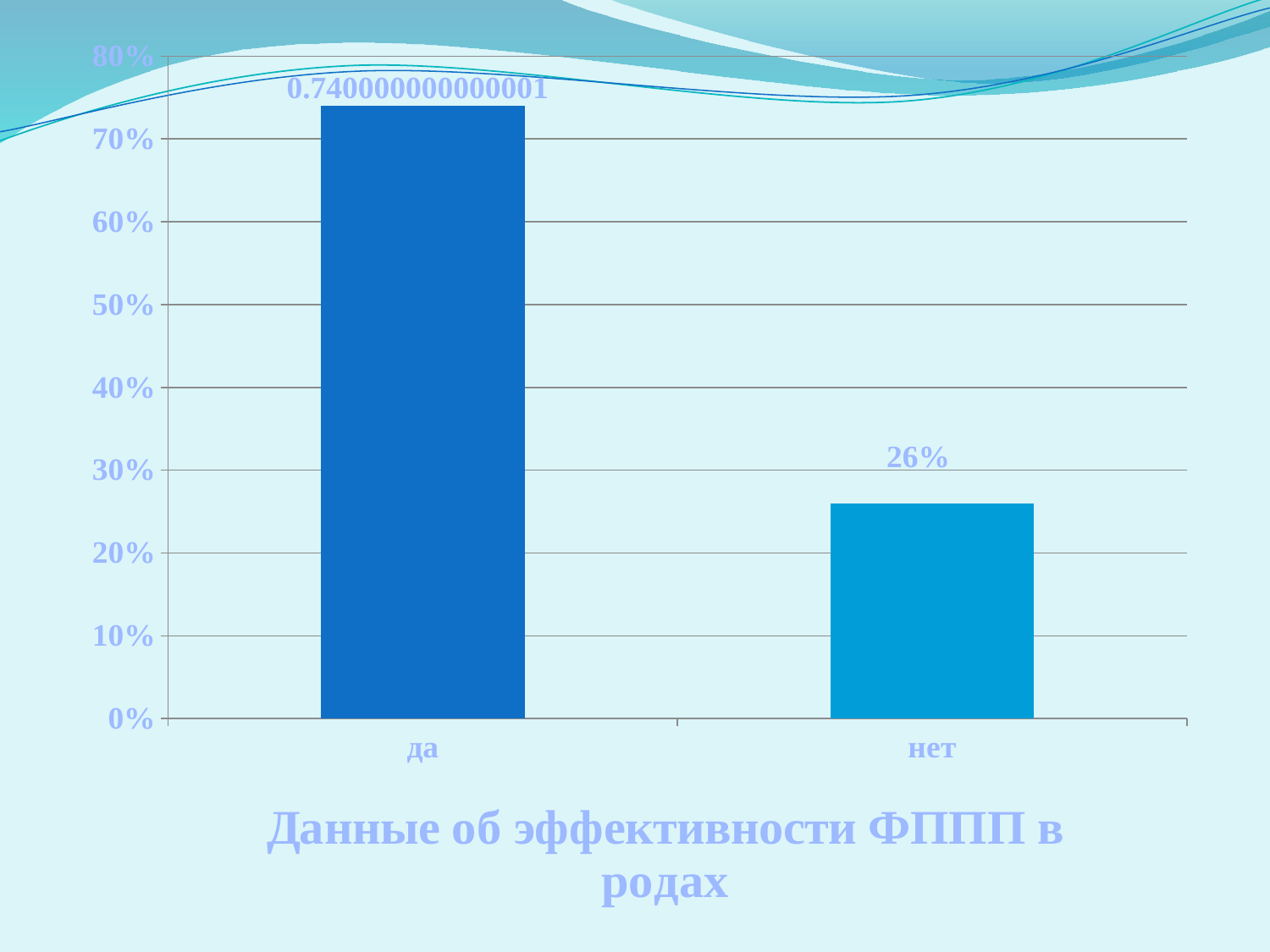
What is the highest value shown on the y axis? 80% Which category has the highest bar? да Is the value for "нет" greater or less than 20%? greater Which bar is taller, "да" or "нет"? да Is the value for "да" greater or less than 70%? greater Is the value for "нет" greater or less than 30%? less What kind of chart is shown on the slide? bar chart What is the data label shown on the bar for "да"? 0.740000000000001 What is the data label shown on the bar for "нет"? 26% What is the title of the chart? Данные об эффективности ФППП в родах How many categories are shown on the x axis? 2 Which category has the lowest bar? нет